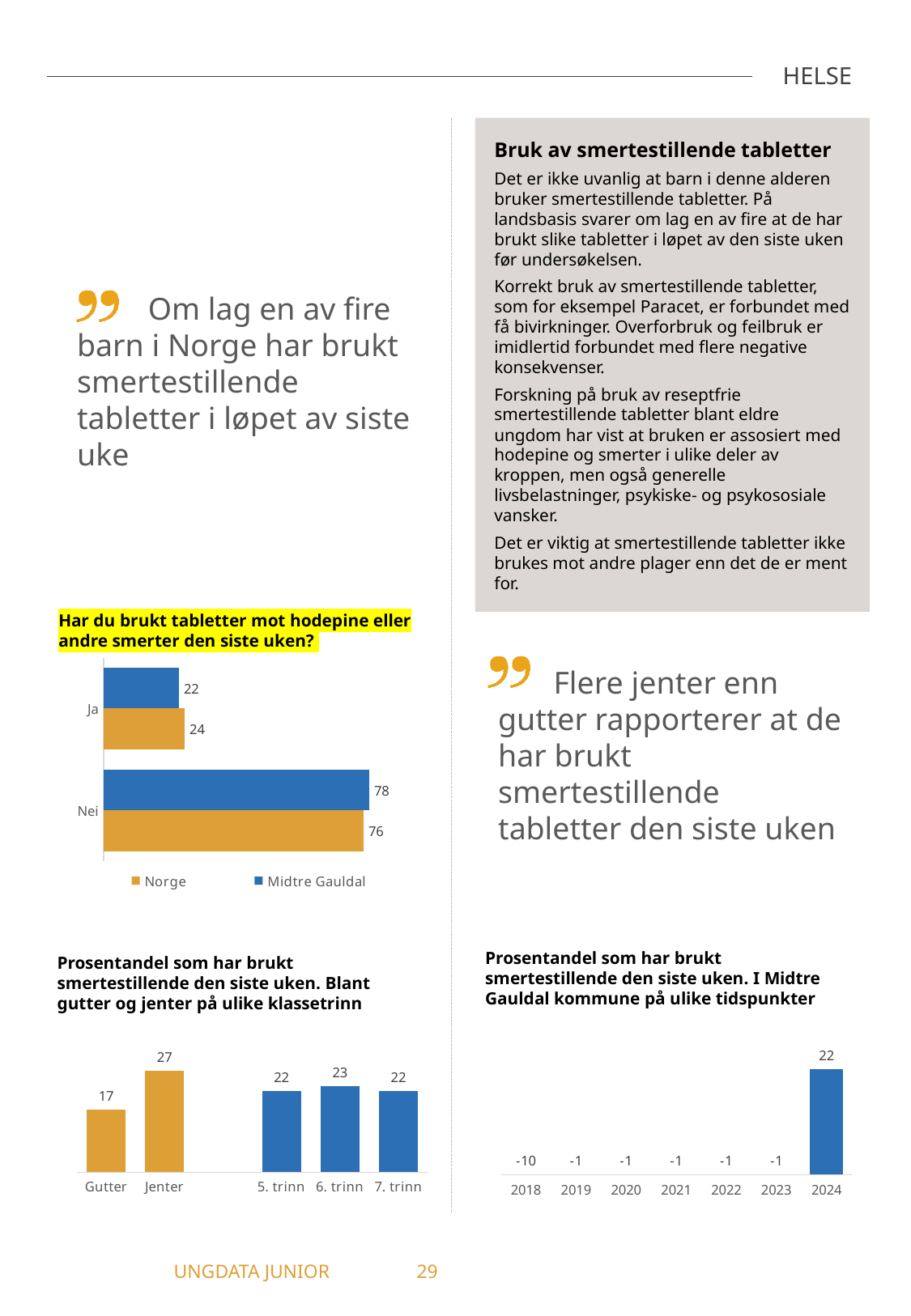
In the chart 'Har du brukt tabletter mot hodepine eller andre smerter den siste uken?', what is the value for Norge in the 'Ja' category? 24 In the chart 'Har du brukt tabletter mot hodepine eller andre smerter den siste uken?', how many series does the legend list? 2 What kind of chart is 'Har du brukt tabletter mot hodepine eller andre smerter den siste uken?'? Bar chart In the chart 'Har du brukt tabletter mot hodepine eller andre smerter den siste uken?', what is the difference between Norge and Midtre Gauldal in the 'Ja' category? 2 In the chart 'Prosentandel som har brukt smertestillende den siste uken. Blant gutter og jenter på ulike klassetrinn', how many categories are shown? 5 In the chart 'Prosentandel som har brukt smertestillende den siste uken. Blant gutter og jenter på ulike klassetrinn', which category has the lowest value? Gutter In the chart 'Prosentandel som har brukt smertestillende den siste uken. Blant gutter og jenter på ulike klassetrinn', what is the difference between Jenter and Gutter? 10 In the chart 'Har du brukt tabletter mot hodepine eller andre smerter den siste uken?', which colour represents Norge? Orange In the chart 'Prosentandel som har brukt smertestillende den siste uken. Blant gutter og jenter på ulike klassetrinn', what is the value for Jenter? 27 In the chart 'Prosentandel som har brukt smertestillende den siste uken. Blant gutter og jenter på ulike klassetrinn', what is the value for 6. trinn? 23 In the chart 'Har du brukt tabletter mot hodepine eller andre smerter den siste uken?', what is the value for Midtre Gauldal in the 'Nei' category? 78 In the chart 'Prosentandel som har brukt smertestillende den siste uken. I Midtre Gauldal kommune på ulike tidspunkter', what is the value for 2024? 22